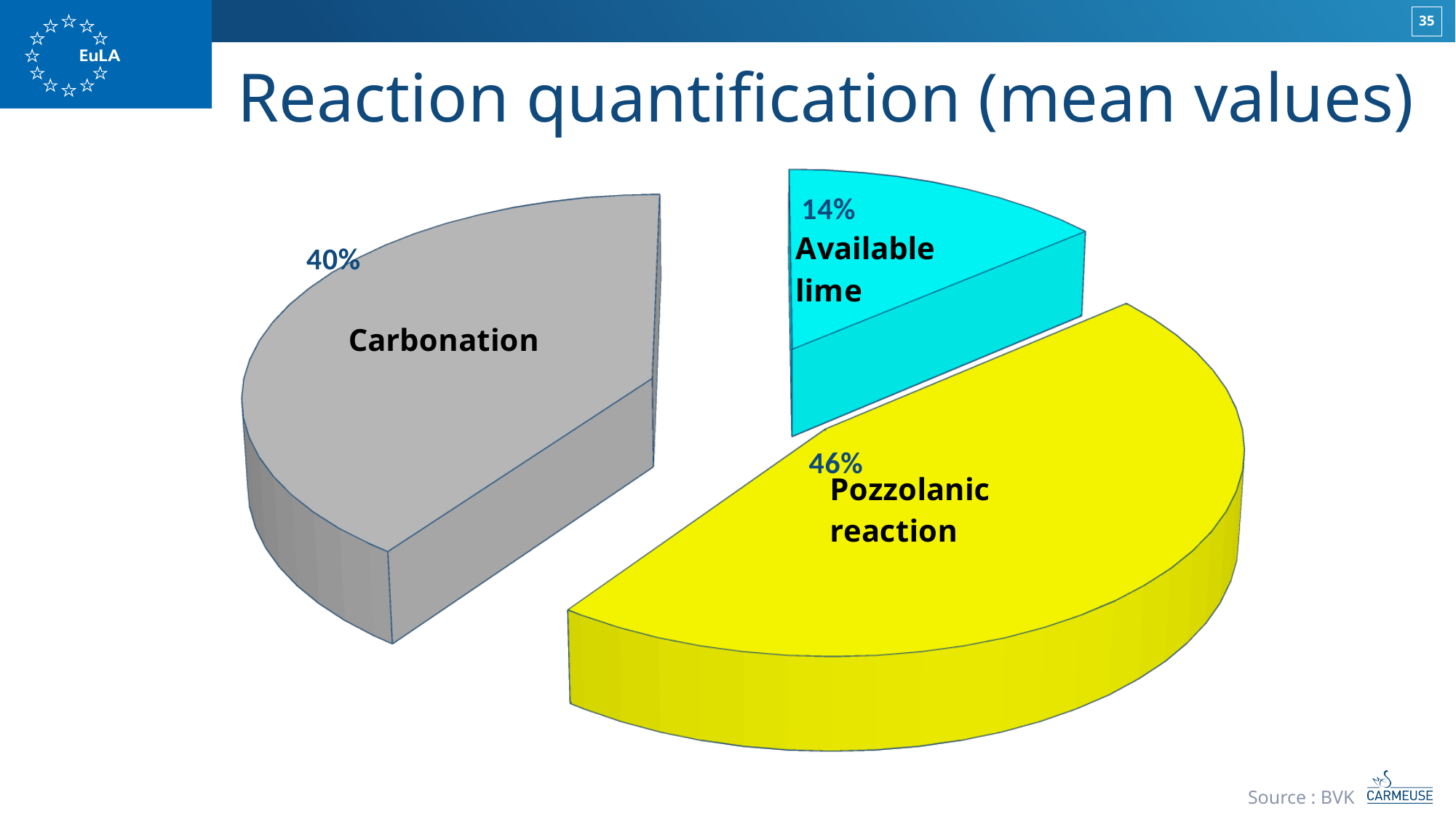
What is the value for Pozzolanic reaction? 46% What is the difference between the Carbonation and Available lime shares? 26% Which is larger, Carbonation or Available lime? Carbonation How many slices does the pie chart have? 3 What is the difference between the Pozzolanic reaction and Carbonation shares? 6% Which category has the smallest share of the pie? Available lime What colour is the Pozzolanic reaction slice? Yellow What is the value for Carbonation? 40% Which category has the largest share of the pie? Pozzolanic reaction What is the title of the chart? Reaction quantification (mean values) What kind of chart is shown on the slide? Pie chart What is the value for Available lime? 14%